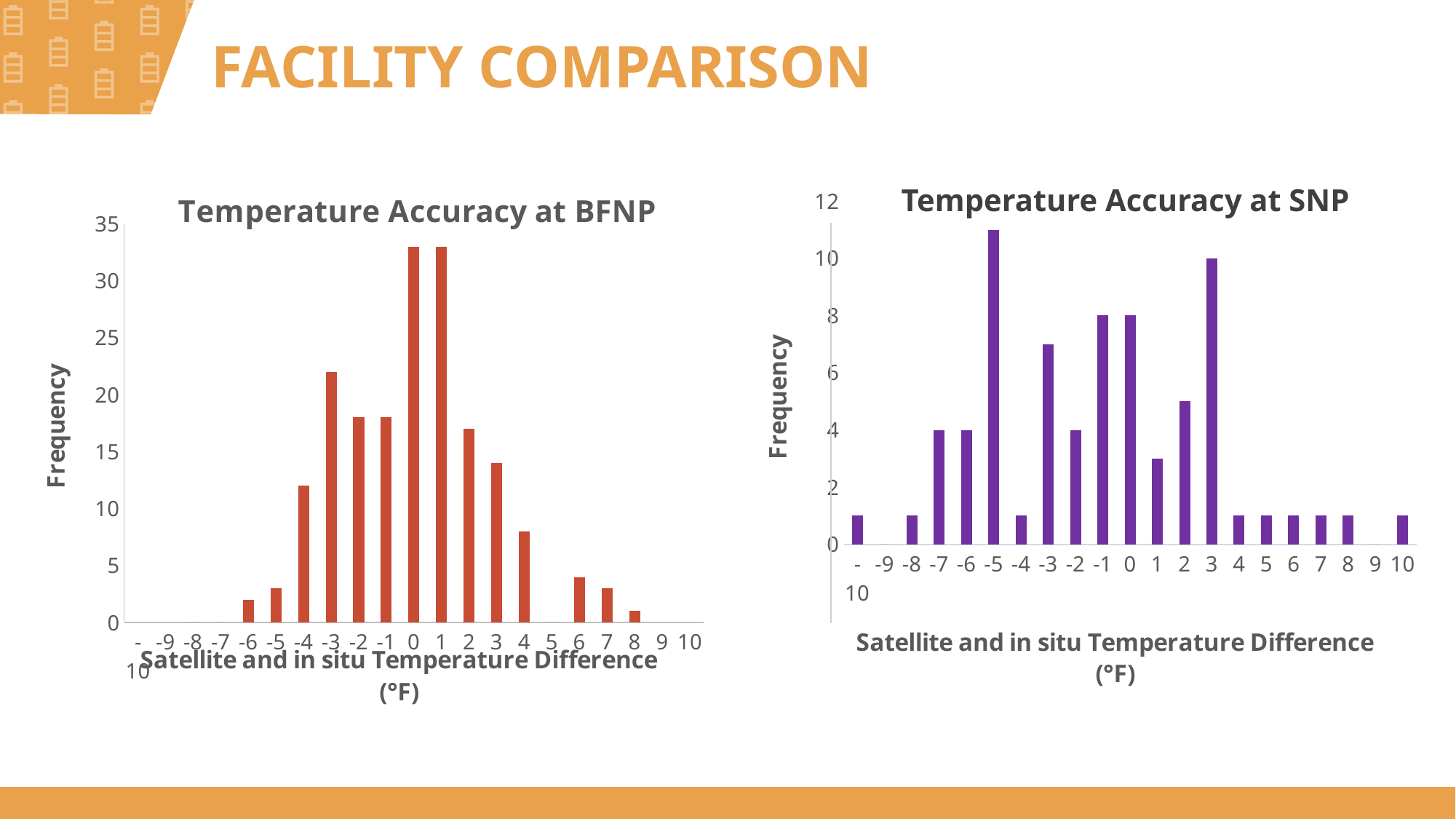
In the "Temperature Accuracy at BFNP" chart, which has the higher frequency: a temperature difference of -3 or -2? -3 What is the y-axis label of the "Temperature Accuracy at BFNP" chart? Frequency In the "Temperature Accuracy at BFNP" chart, is the frequency for a temperature difference of -3 greater or less than 20? greater In the "Temperature Accuracy at SNP" chart, is the frequency for a temperature difference of -5 greater or less than 10? greater In the "Temperature Accuracy at SNP" chart, which temperature difference has the highest frequency? -5 In the "Temperature Accuracy at BFNP" chart, is the frequency for a temperature difference of 0 greater or less than 30? greater What kind of chart is the "Temperature Accuracy at BFNP" chart? bar chart In the "Temperature Accuracy at SNP" chart, which has the higher frequency: a temperature difference of 3 or 2? 3 What colour are the bars in the "Temperature Accuracy at SNP" chart? purple How many temperature difference categories are shown on the x axis of the "Temperature Accuracy at SNP" chart? 21